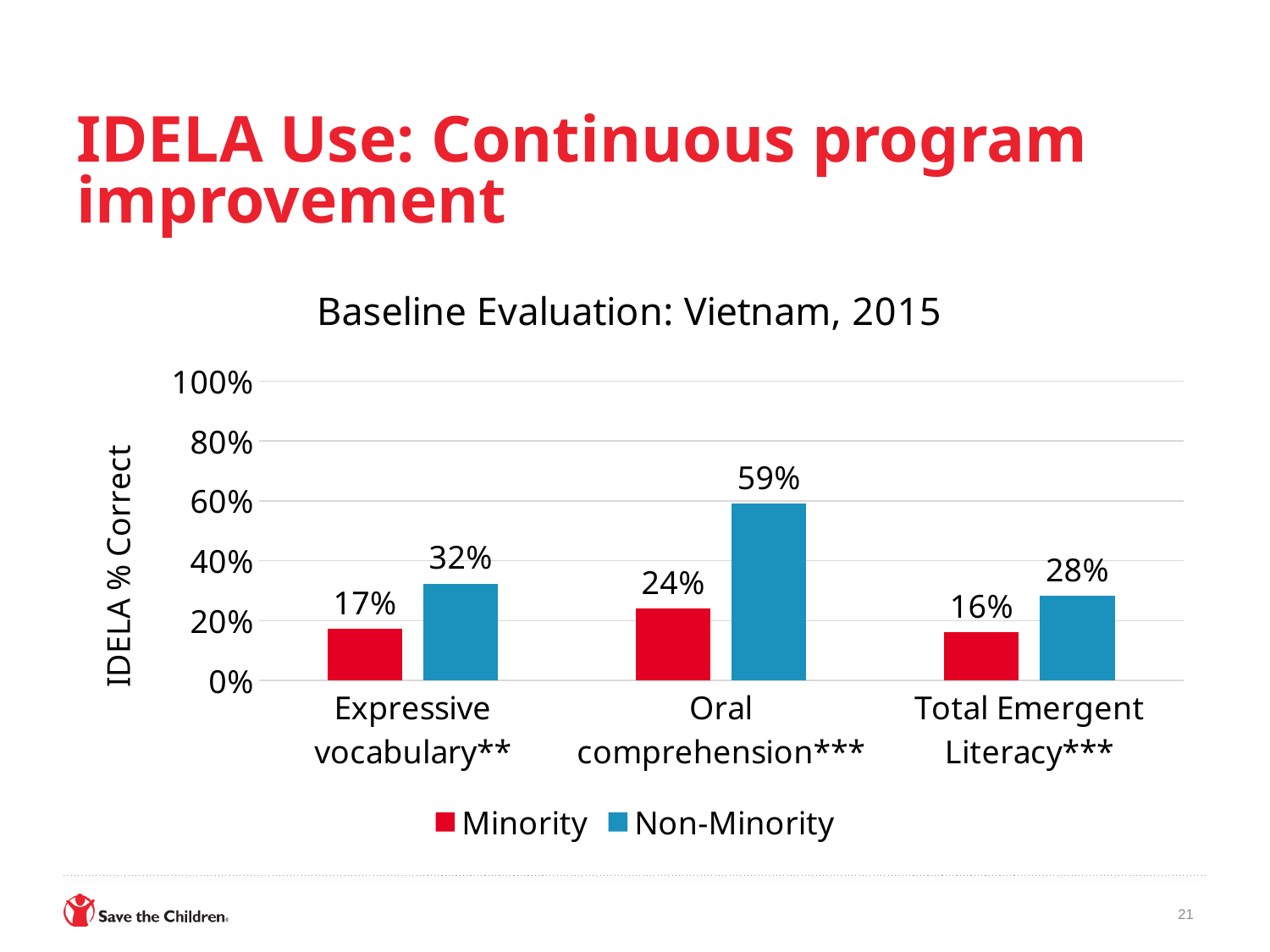
Which category has the lowest Minority value? Total Emergent Literacy*** Which is larger for Total Emergent Literacy***: the Minority value or the Non-Minority value? Non-Minority What is the difference between the Non-Minority and Minority values for Oral comprehension***? 35% Which category has the highest Non-Minority value? Oral comprehension*** What is the Non-Minority value for Expressive vocabulary**? 32% Is the Non-Minority value for Oral comprehension*** greater or less than 40%? greater What is the Minority value for Total Emergent Literacy***? 16% What is the title of the chart? Baseline Evaluation: Vietnam, 2015 What kind of chart is shown on the slide? Bar chart What is the Minority value for Oral comprehension***? 24% How many categories are shown on the x axis? 3 How many series does the legend list? 2